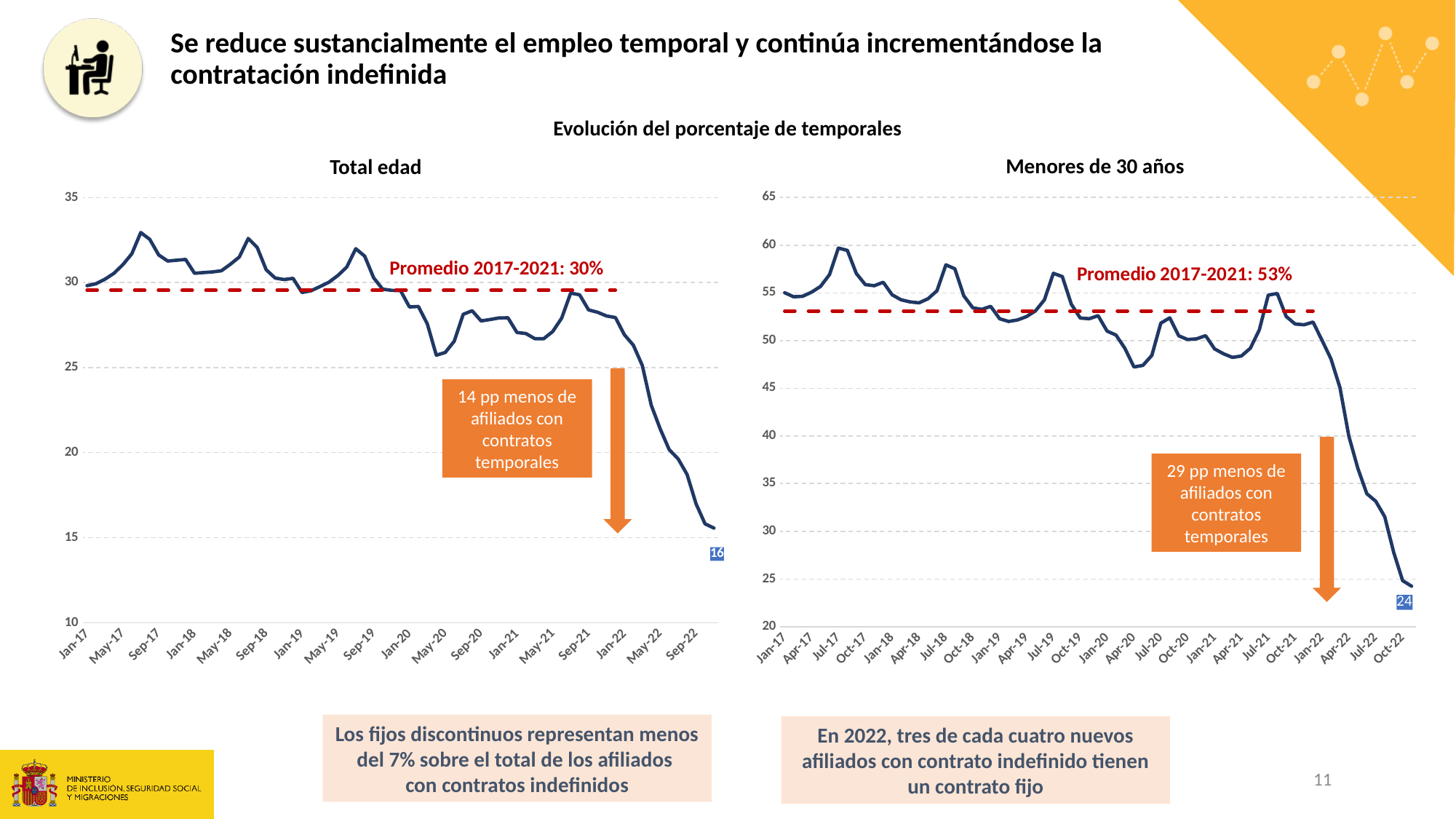
On the 'Menores de 30 años' chart, is the value for Oct-22 greater or less than 30? less On the 'Menores de 30 años' chart, what is the 'Promedio 2017-2021' value shown? 53% On the 'Total edad' chart, what is the value shown by the data label at the end of the line? 16 On the 'Total edad' chart, do the values rise or fall from Jan-22 to Sep-22? fall On the 'Menores de 30 años' chart, is the value for Apr-20 greater or less than 50? less What kind of chart is the 'Total edad' chart? line chart What is the difference between the final labelled value on the 'Menores de 30 años' chart and the final labelled value on the 'Total edad' chart? 8 On the 'Total edad' chart, is the value for Sep-22 greater or less than 20? less On the 'Menores de 30 años' chart, what is the value shown by the data label at the end of the line? 24 On the 'Total edad' chart, what is the 'Promedio 2017-2021' value shown? 30% Which chart ends with the larger final labelled value, 'Total edad' or 'Menores de 30 años'? Menores de 30 años